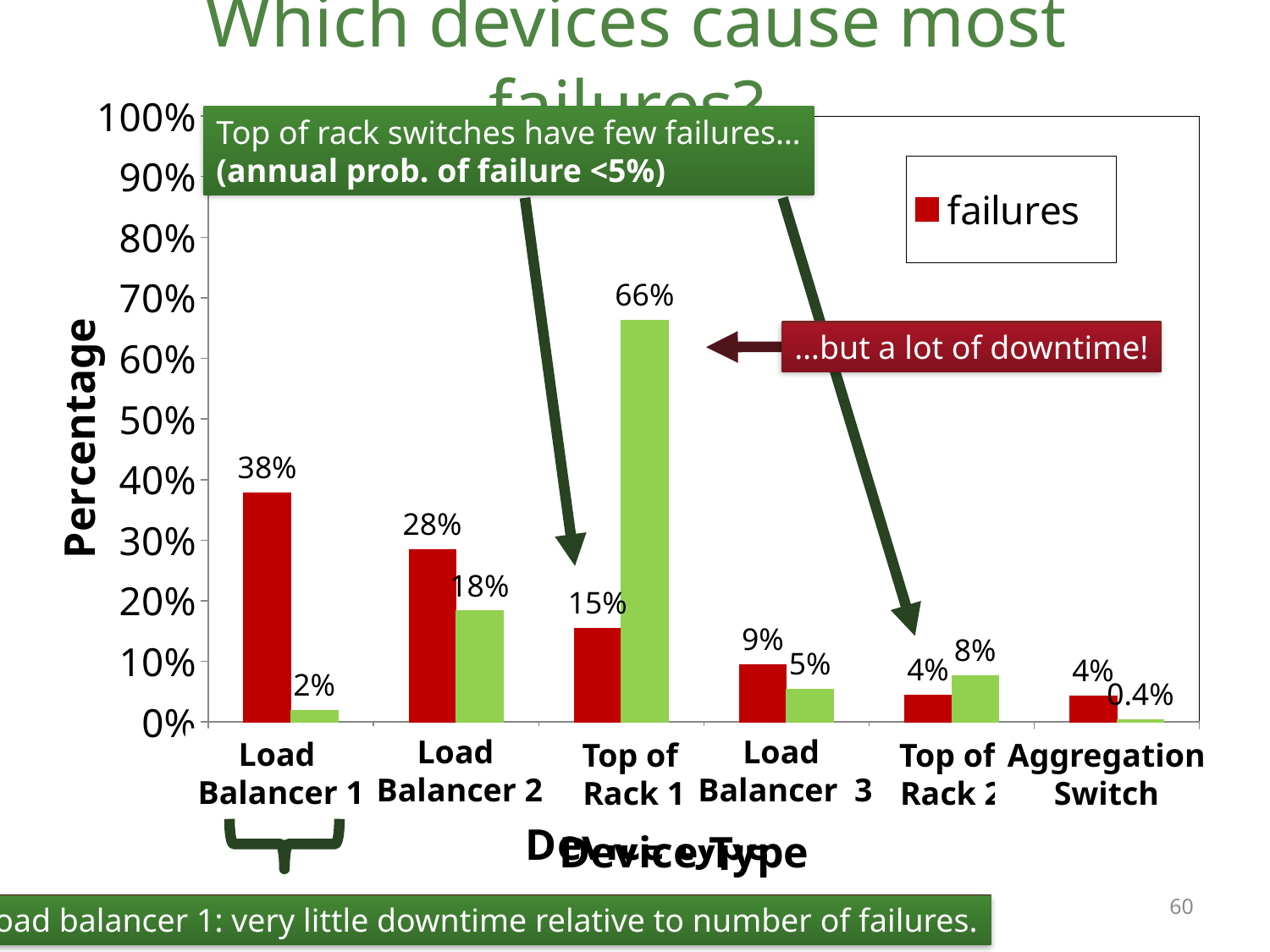
How many device types are shown on the x axis? 6 What is the failures value for Load Balancer 1? 38% What is the failures value for Load Balancer 3? 9% What is the value of the green bar for Aggregation Switch? 0.4% What type of chart is shown on the slide? bar chart What is the value of the green bar for Top of Rack 1? 66% Which device type has the highest green bar? Top of Rack 1 For Top of Rack 1, which is larger: the failures bar or the green bar? the green bar Which device type has the highest failures value? Load Balancer 1 What is the difference between the failures value and the green bar value for Load Balancer 1? 36 percentage points Which device type has the lowest green bar? Aggregation Switch Do the failures values generally rise or fall from left to right along the x axis? fall